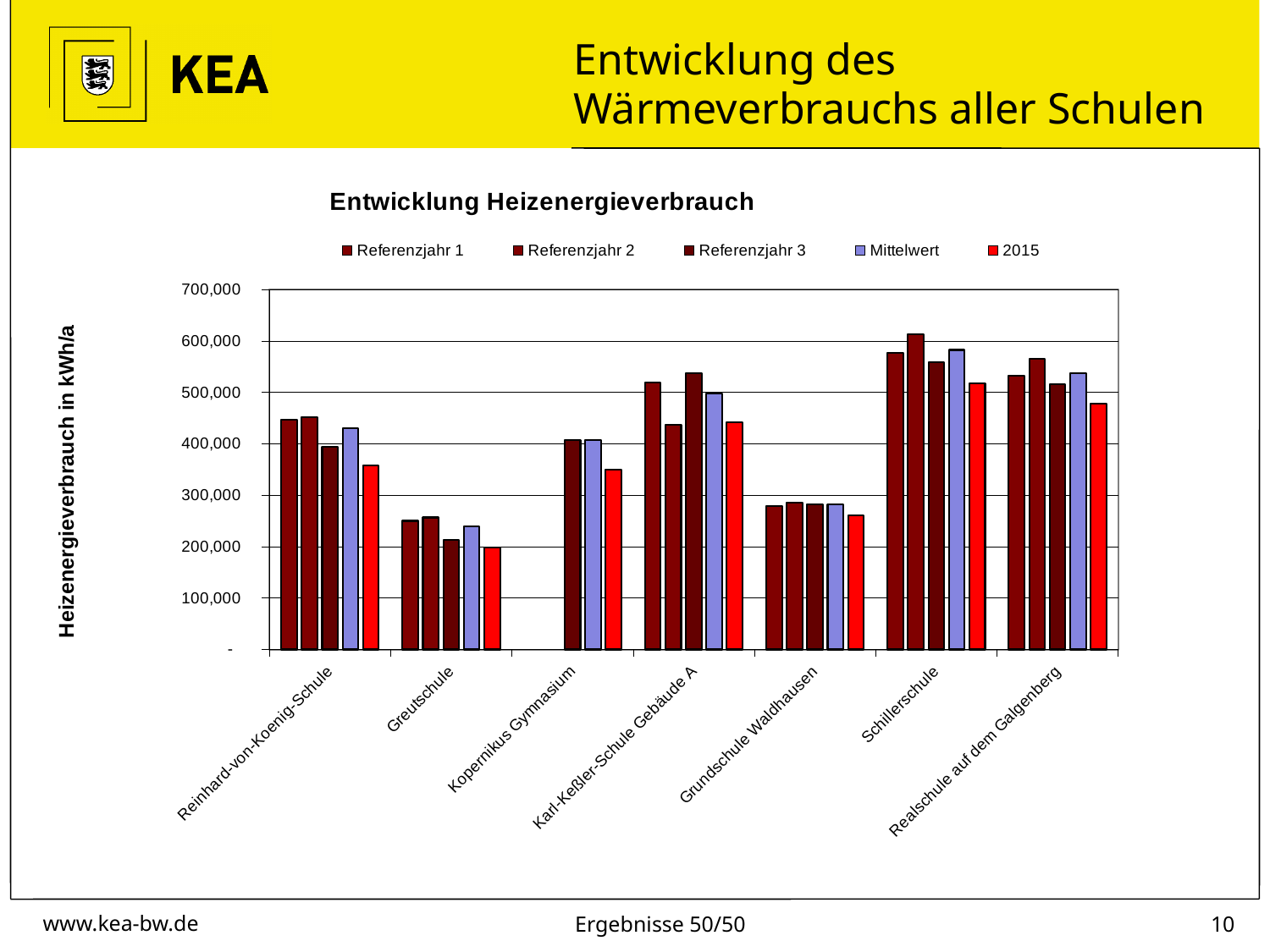
Is the Referenzjahr 2 value for Schillerschule greater or less than 600,000? greater For Karl-Keßler-Schule Gebäude A, which is larger: the Referenzjahr 2 value or the Referenzjahr 3 value? Referenzjahr 3 How many series does the legend of the chart list? 5 What is the title of the y axis of the chart? Heizenergieverbrauch in kWh/a Which school has the lowest value for 2015? Greutschule What kind of chart is shown on the slide? bar chart How many schools are shown on the x axis of the chart? 7 For Reinhard-von-Koenig-Schule, which is larger: the Mittelwert value or the 2015 value? Mittelwert Which school has the highest Mittelwert value? Schillerschule Is the 2015 value for Greutschule greater or less than 300,000? less Which school has the highest value for 2015? Schillerschule Is the Mittelwert value for Grundschule Waldhausen greater or less than 300,000? less